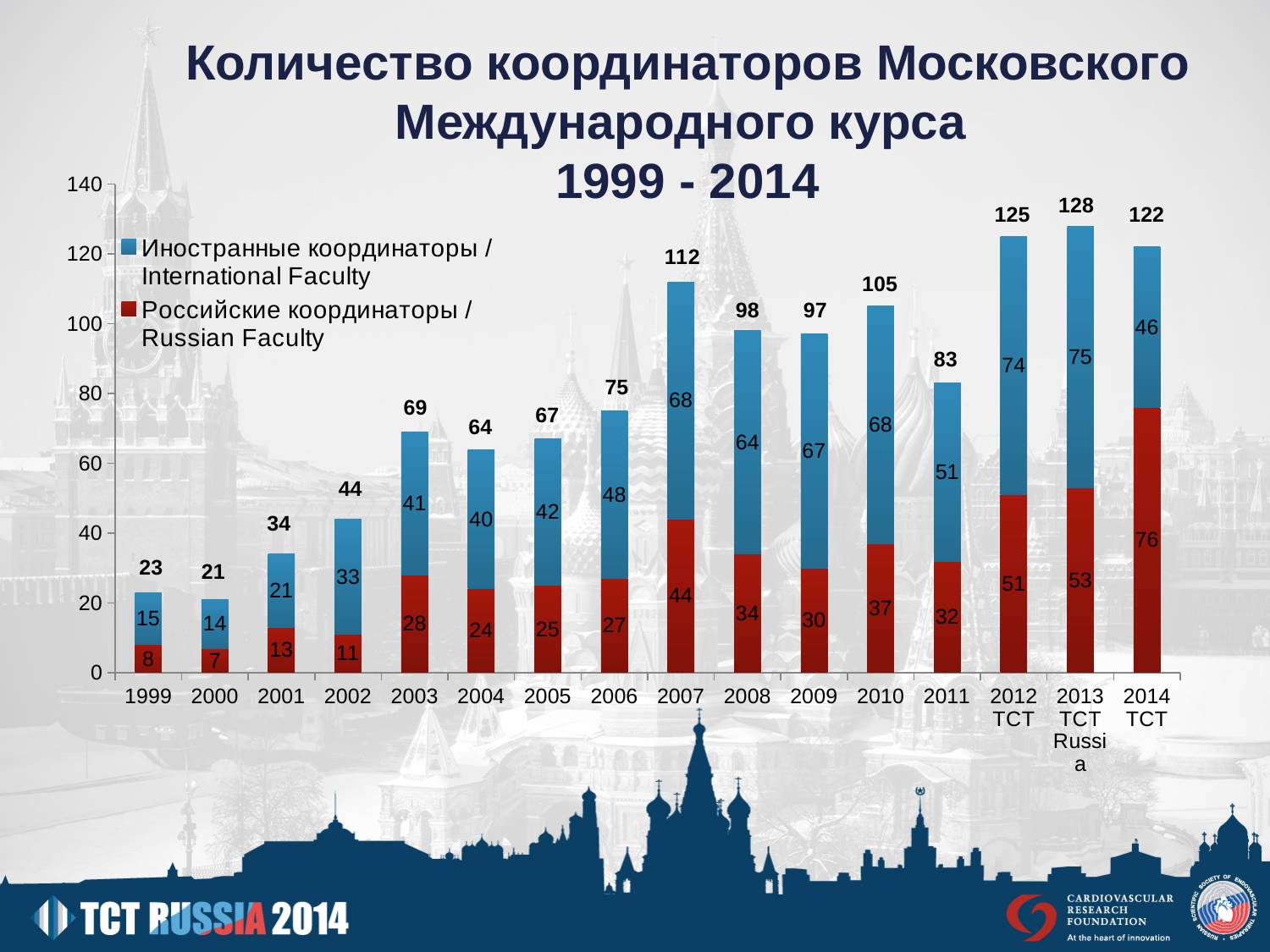
What kind of chart is shown on the slide? Stacked bar chart What is the value for Russian Faculty (Российские координаторы) in 2007? 44 Which year has the lowest total number of coordinators? 2000 Which year has the highest total number of coordinators? 2013 TCT Russia What is the total of the stacked bar for 2013 TCT Russia? 128 Which colour represents Russian Faculty (Российские координаторы) in the chart? Red In 2014 TCT, which is larger: the International Faculty value or the Russian Faculty value? Russian Faculty How many years (categories) are shown on the x axis? 16 What is the value for International Faculty (Иностранные координаторы) in 2012 TCT? 74 What is the difference between the total for 2012 TCT and the total for 2011? 42 How many series does the legend list? 2 Is the total for 2010 greater or less than 100? greater